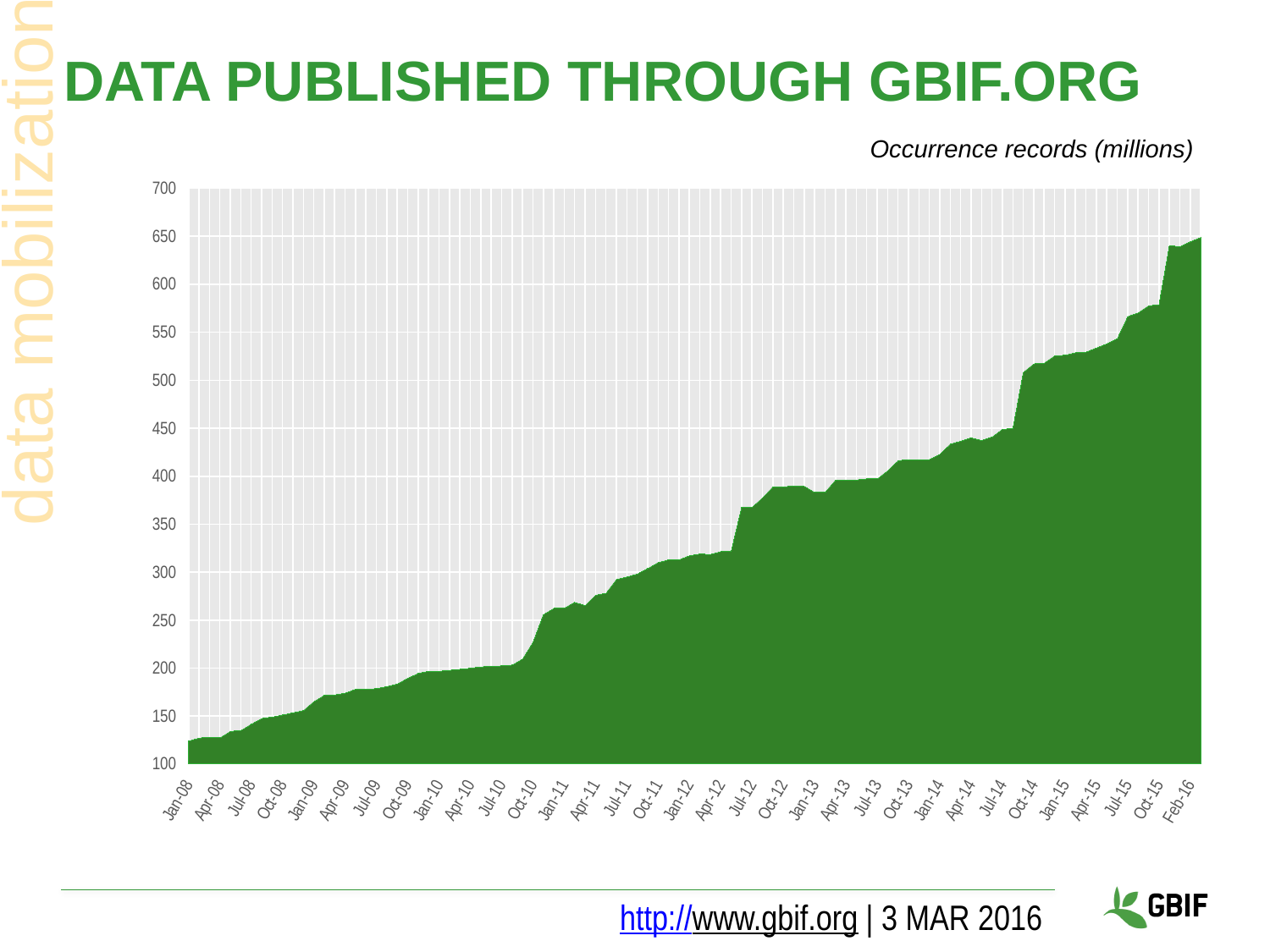
Is the value for Jan-13 greater or less than 350? greater Which x-axis label has the highest value? Feb-16 Do the values rise or fall from Jan-08 to Feb-16? rise What kind of chart is shown on the slide? area chart Is the value for Feb-16 greater or less than 600? greater Is the value for Jan-15 greater or less than 500? greater What unit does the chart's subtitle say the values are in? Occurrence records (millions) Which x-axis label has the lowest value? Jan-08 What is the title of the slide's chart? DATA PUBLISHED THROUGH GBIF.ORG Which has the larger value, Jan-10 or Jan-14? Jan-14